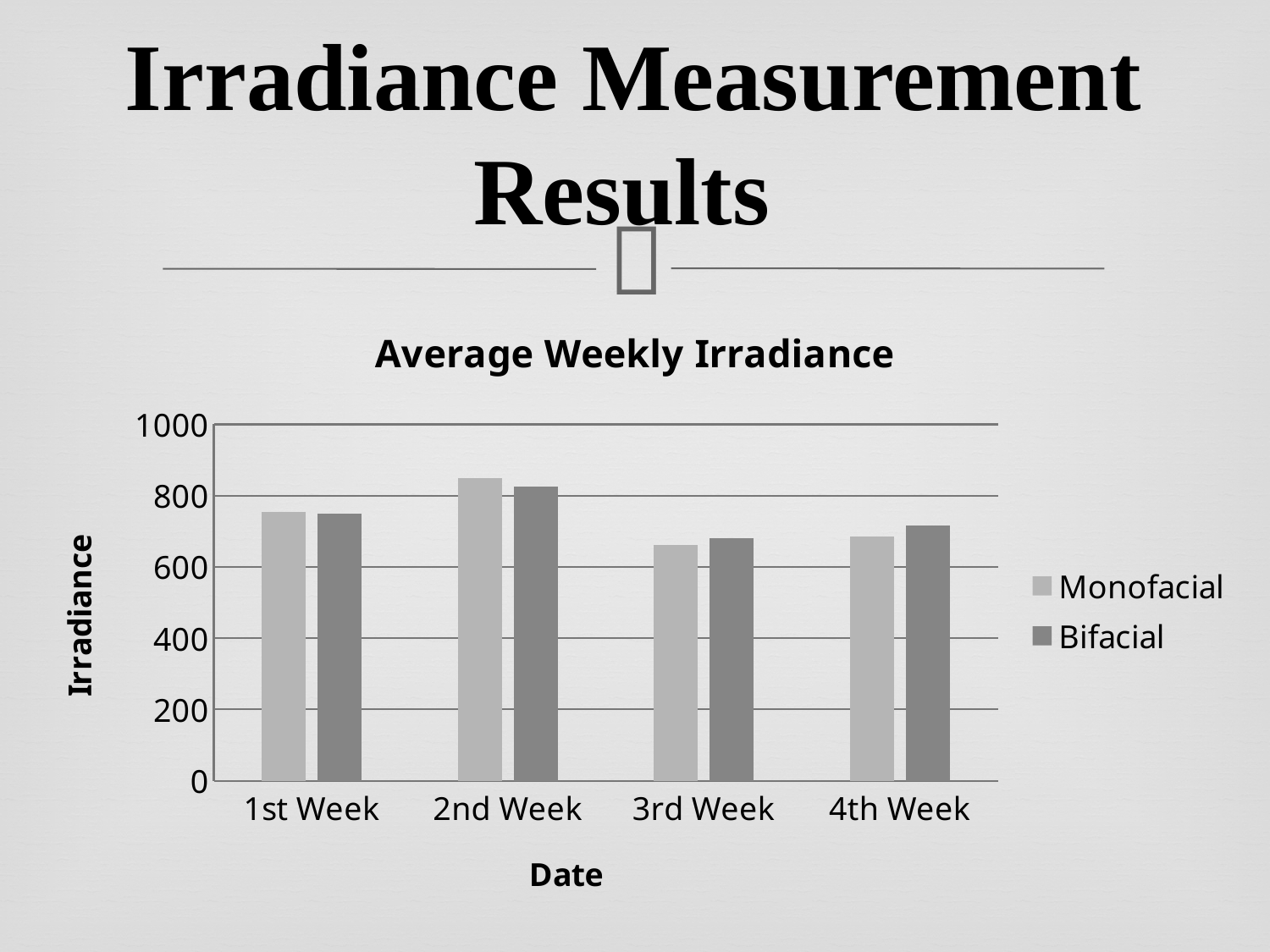
Is the Bifacial value for the 3rd Week greater or less than 800? less Which week has the highest Bifacial value? 2nd Week Is the Monofacial value for the 2nd Week greater or less than 800? greater How many week categories are shown on the x axis? 4 What kind of chart is shown on the slide? Bar chart In the 4th Week, which is larger, Monofacial or Bifacial? Bifacial Which week has the highest Monofacial value? 2nd Week What is the label on the vertical axis? Irradiance Which week has the lowest Bifacial value? 3rd Week How many series does the legend list? 2 Which week has the lowest Monofacial value? 3rd Week What is the title of the chart? Average Weekly Irradiance